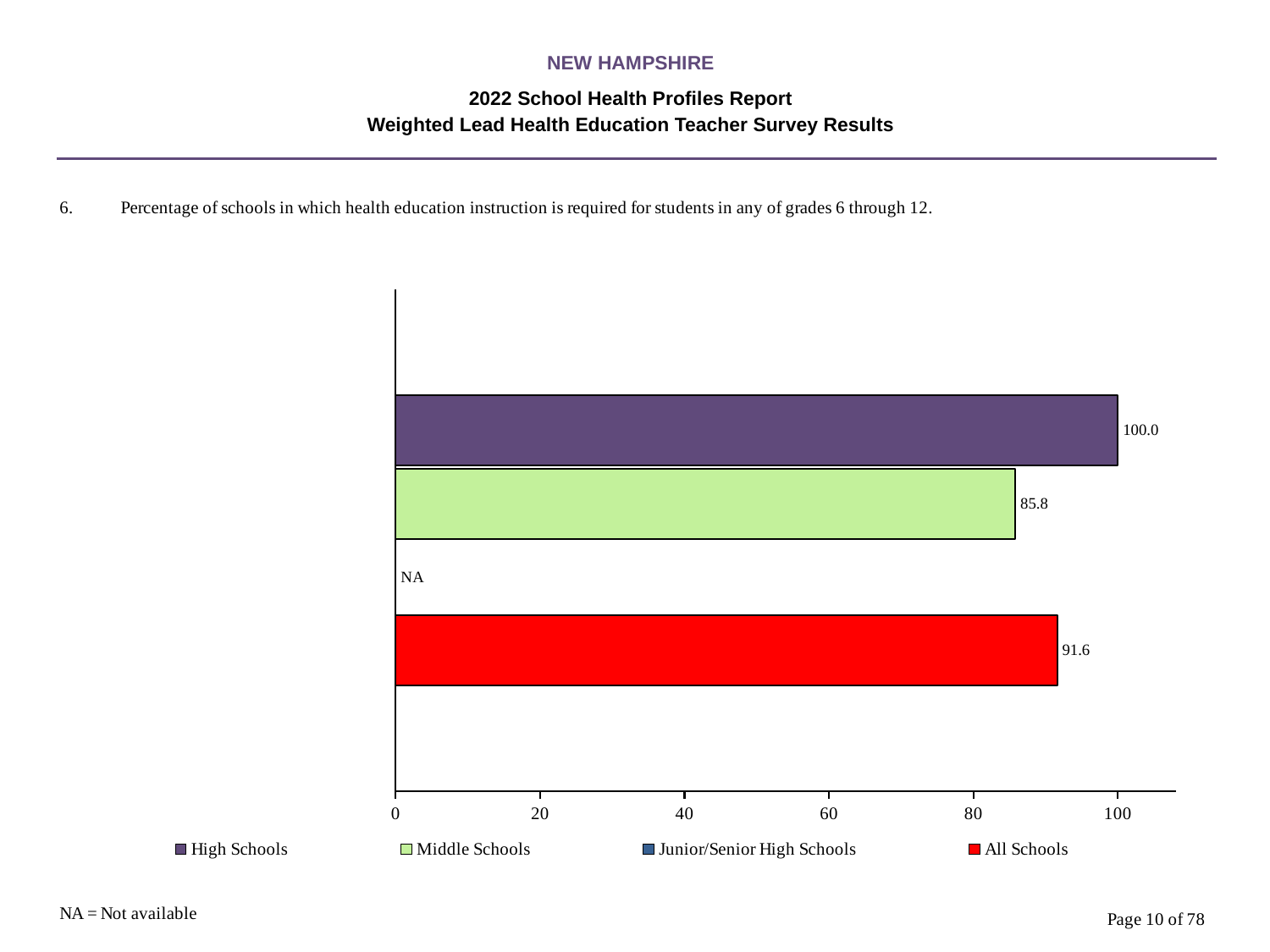
What is the value for All Schools? 91.6 What is the value for High Schools? 100.0 What is the difference between the High Schools value and the Middle Schools value? 14.2 What is the difference between the All Schools value and the Middle Schools value? 5.8 Which school type has the highest value? High Schools What is shown for Junior/Senior High Schools? NA What is the value for Middle Schools? 85.8 Among the school types with a plotted value, which has the lowest? Middle Schools Is the value for Middle Schools greater or less than 80? greater What kind of chart is shown on the slide? bar chart Which is larger, the value for All Schools or the value for Middle Schools? All Schools How many series does the legend list? 4